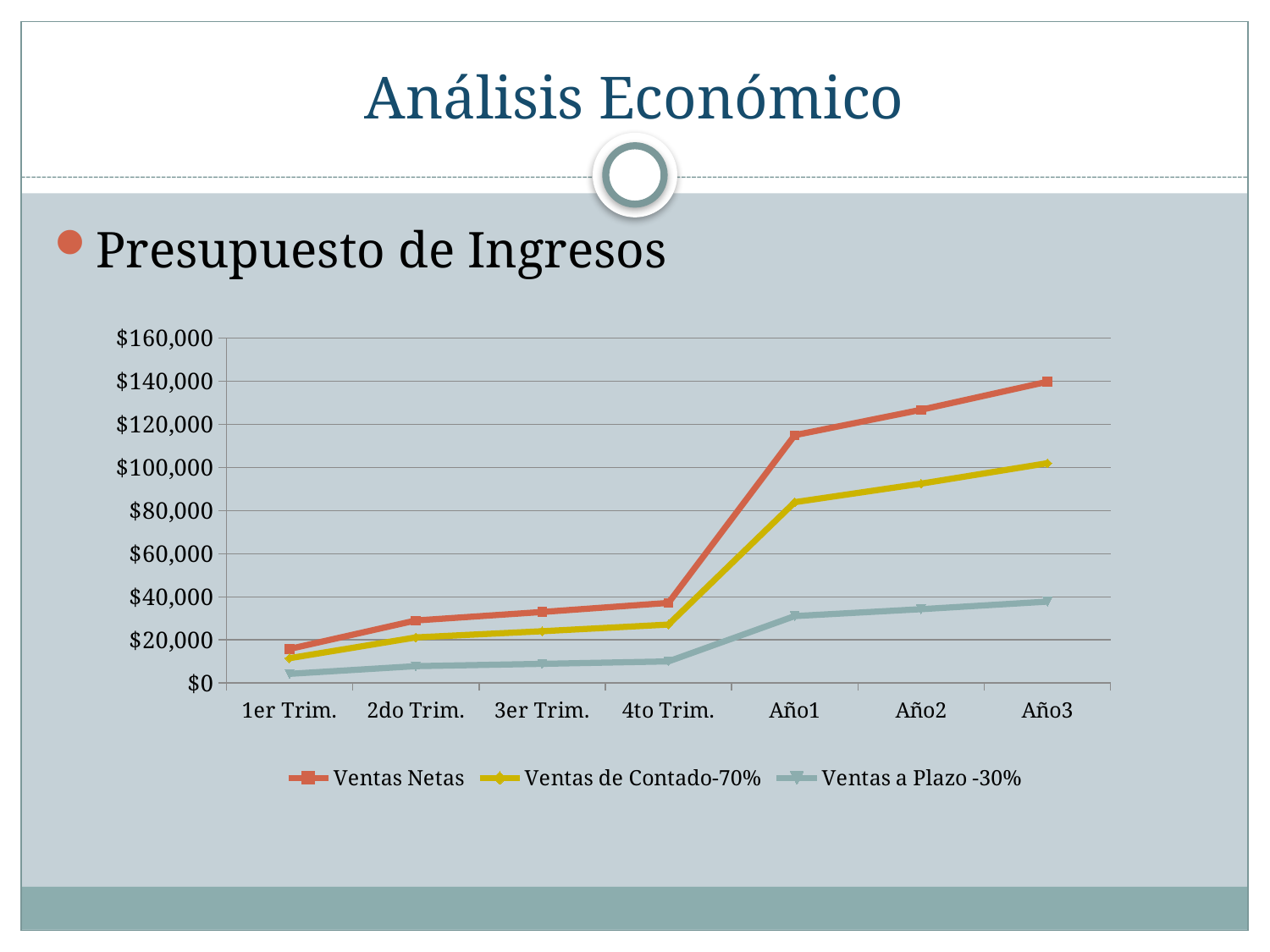
What kind of chart is shown on the slide? Line chart How many series does the legend list? 3 Which series is shown in red/orange in the legend? Ventas Netas How many categories are shown along the x axis? 7 Is the value for Ventas a Plazo -30% at Año3 greater or less than $60,000? less At which category is Ventas de Contado-70% lowest? 1er Trim. What is the third series listed in the legend? Ventas a Plazo -30% Is the value for Ventas Netas at Año1 greater or less than $100,000? greater At which category does Ventas Netas reach its highest value? Año3 Is the value for Ventas Netas at 1er Trim. greater or less than $20,000? less At Año2, which is larger: Ventas Netas or Ventas a Plazo -30%? Ventas Netas